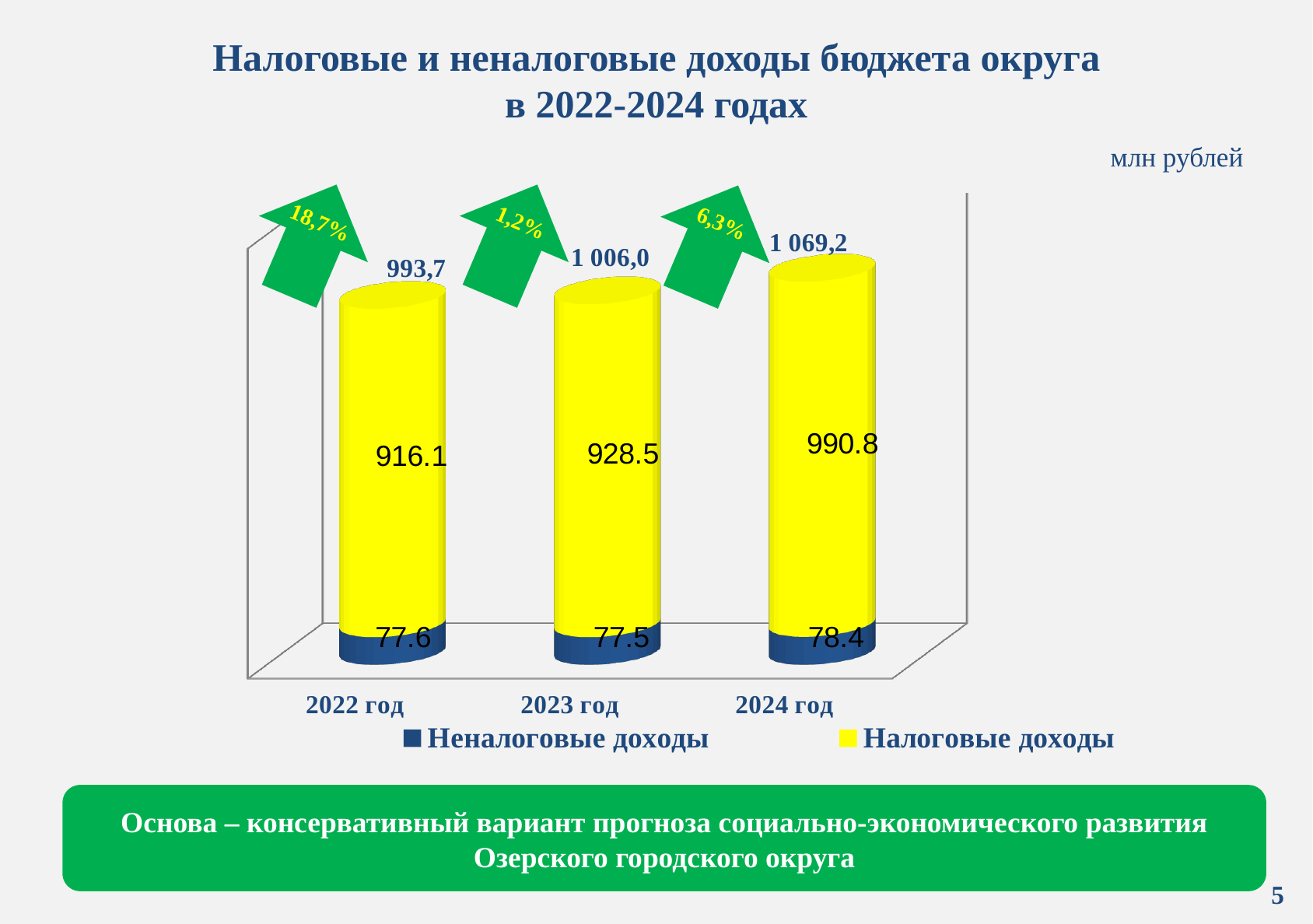
Which year has the lowest value of Неналоговые доходы? 2023 год Which year has the highest value of Налоговые доходы? 2024 год What is the value of Неналоговые доходы for 2022 год? 77.6 What is the value of Налоговые доходы for 2023 год? 928.5 How many years are shown on the x axis? 3 What is the value of Неналоговые доходы for 2024 год? 78.4 How many series does the legend list? 2 What is the total shown above the bar for 2024 год? 1 069,2 What kind of chart is shown on the slide? Stacked bar chart Which is larger: Налоговые доходы in 2022 год or in 2023 год? 2023 год What is the total shown above the bar for 2022 год? 993,7 What is the difference between Налоговые доходы in 2024 год and 2023 год? 62.3